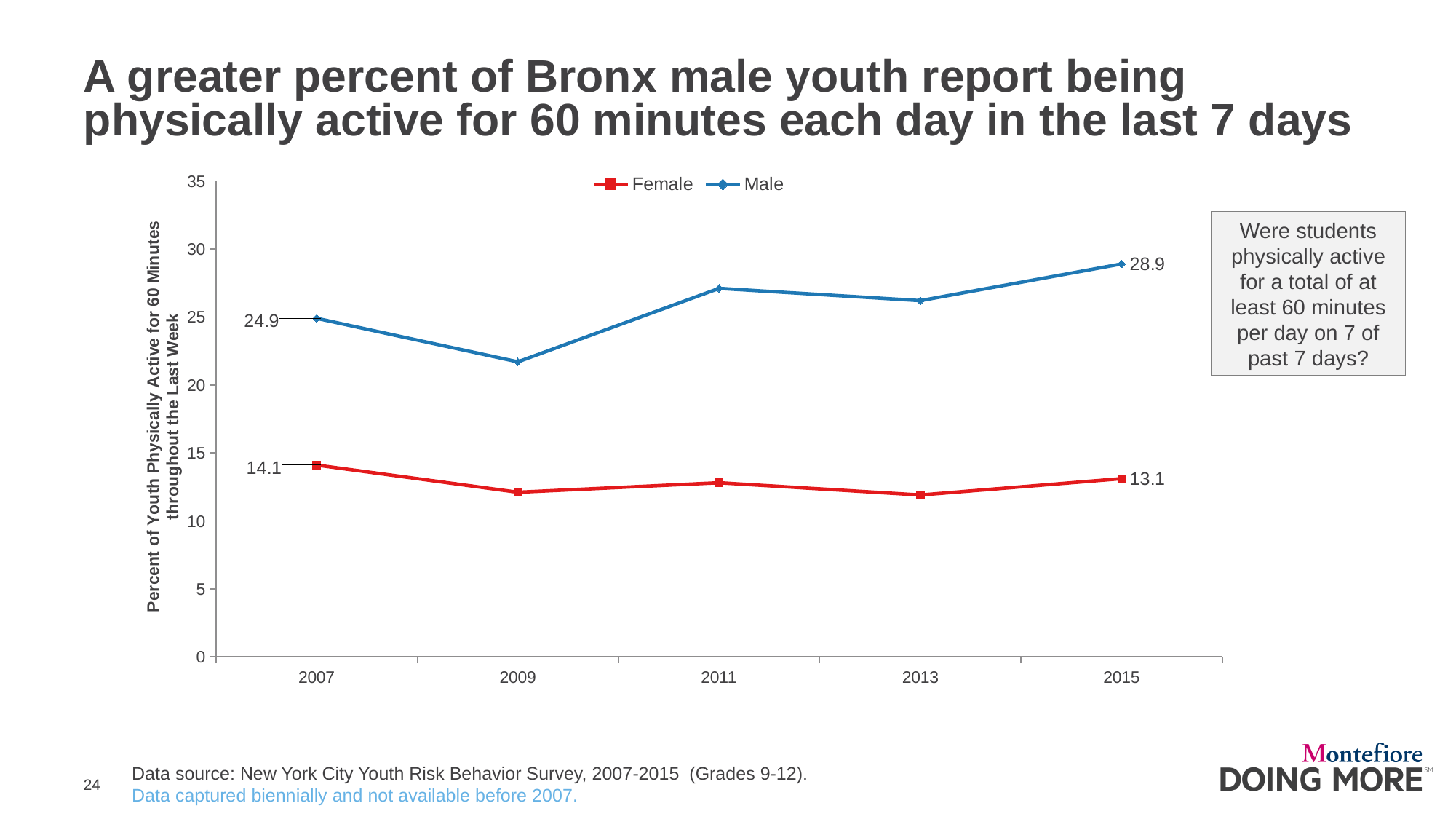
In which year is the Male value lowest? 2009 What is the Female value in 2007? 14.1 What is the Female value in 2015? 13.1 What is the Male value in 2015? 28.9 What is the difference between the Male and Female values in 2015? 15.8 What is the Male value in 2007? 24.9 Is the Male value in 2009 greater or less than 20? greater What kind of chart is shown on the slide? Line chart How many series does the legend list? 2 Which series has the higher value in 2011, Female or Male? Male By how much did the Male value change from 2007 to 2015? 4 How many years are shown on the x axis? 5